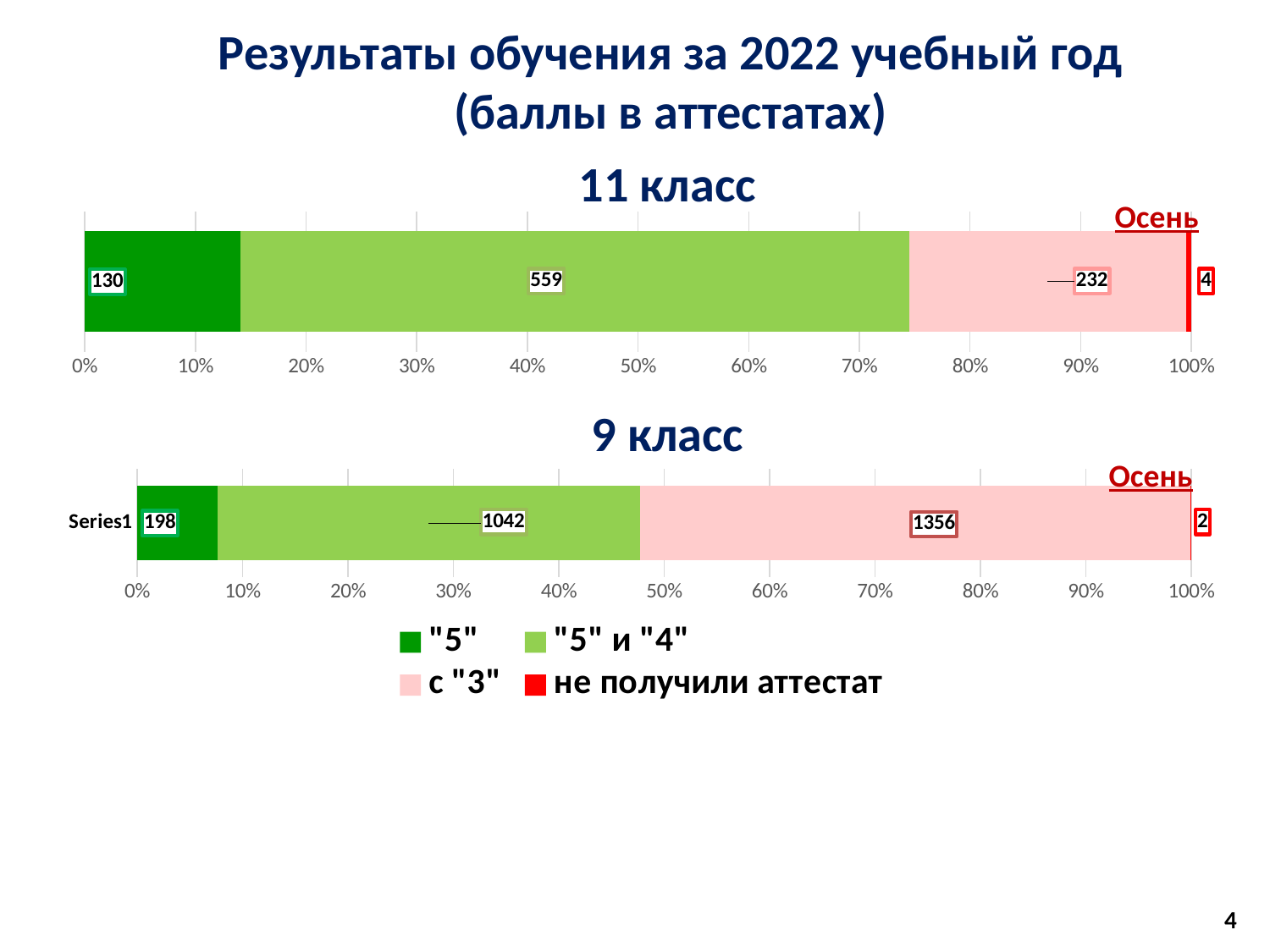
In the "11 класс" chart, which segment has the largest value? "5" и "4" What kind of chart is the "9 класс" chart? Stacked bar chart What is the total of all segments in the "11 класс" bar? 925 How many series does the legend list? 4 In the "11 класс" chart, what is the value for the "5" segment? 130 In the "9 класс" chart, which is larger: the "5" и "4" value or the с "3" value? с "3" In the "11 класс" chart, what is the difference between the "5" и "4" value and the с "3" value? 327 In the "11 класс" chart, what is the value for the "5" и "4" segment? 559 In the "9 класс" chart, which segment has the smallest value? не получили аттестат In the "9 класс" chart, what is the value for the с "3" segment? 1356 What is the total of all segments in the "9 класс" bar? 2598 In the "9 класс" chart, what is the value for the "не получили аттестат" segment? 2